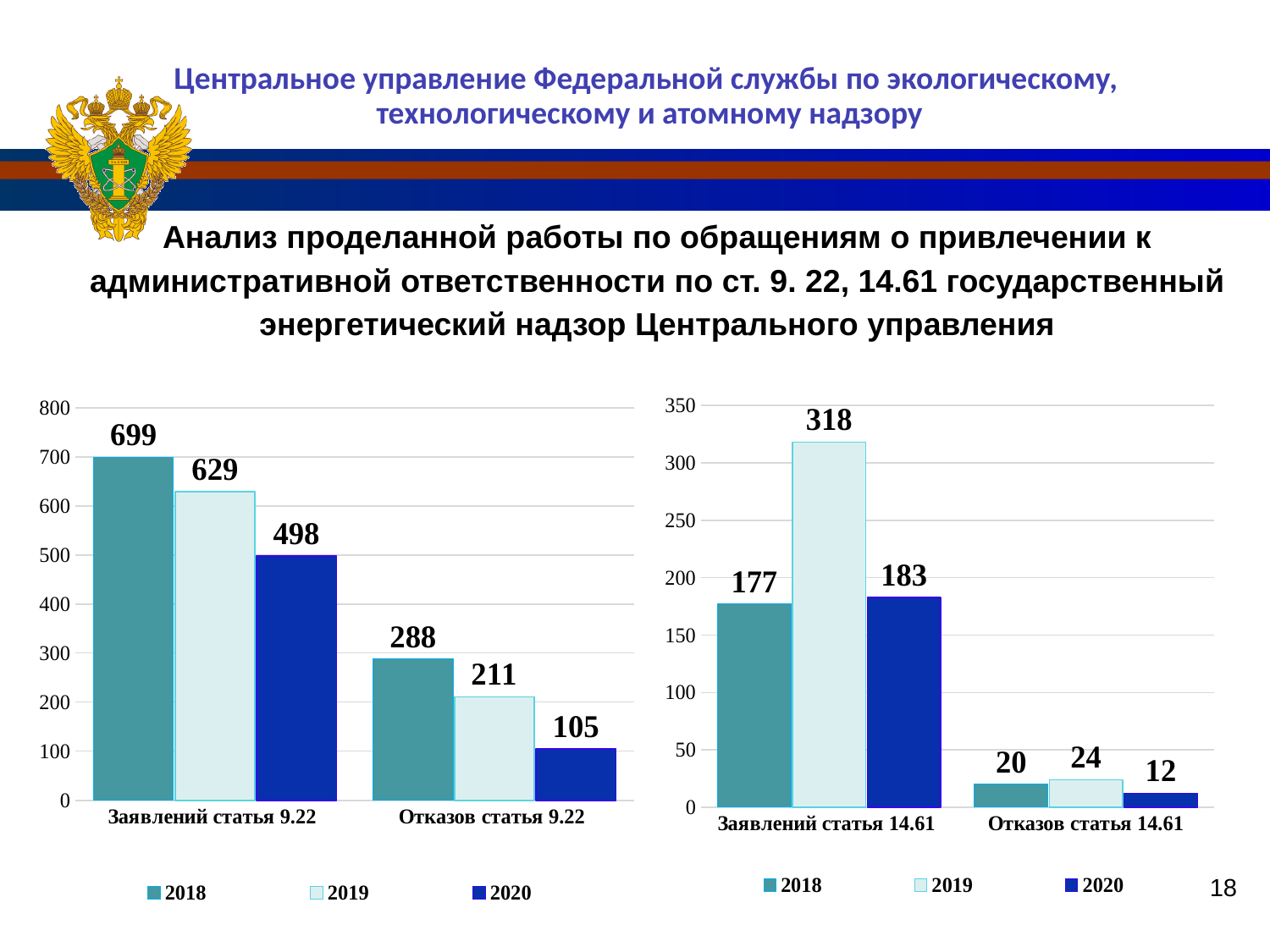
How many series does the legend of the right chart list? 3 In the left chart, which year has the highest value in the category "Заявлений статья 9.22"? 2018 In the left chart, do the values for "Отказов статья 9.22" rise or fall from 2018 to 2020? fall In the right chart, which year has the lowest value in the category "Отказов статья 14.61"? 2020 In the right chart, what is the difference between the 2019 and 2018 values for "Заявлений статья 14.61"? 141 In the right chart, what is the value for 2020 in the category "Отказов статья 14.61"? 12 In the left chart, what is the difference between the 2018 and 2020 values for "Заявлений статья 9.22"? 201 In the left chart, what is the value for 2018 in the category "Заявлений статья 9.22"? 699 In the right chart, which is larger: the 2018 value or the 2020 value for "Заявлений статья 14.61"? 2020 In the left chart, what is the value for 2020 in the category "Отказов статья 9.22"? 105 What type of chart is the left chart? bar chart In the right chart, what is the value for 2019 in the category "Заявлений статья 14.61"? 318